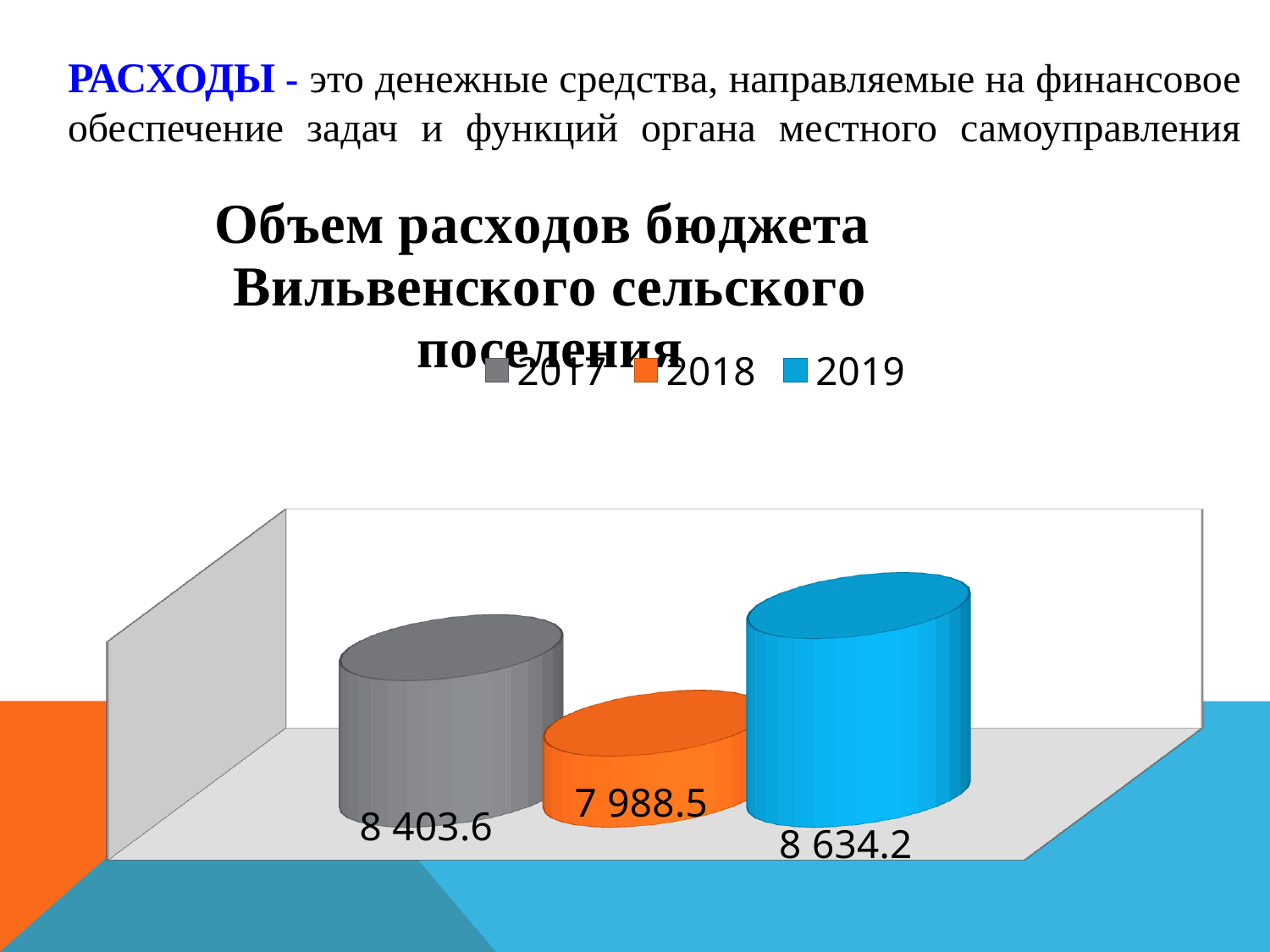
Which is larger, the value for 2017 or the value for 2018? 2017 How many series does the legend list? 3 What is the value shown for 2017? 8 403.6 What is the value shown for 2019? 8 634.2 Which year has the lowest value? 2018 What is the difference between the values for 2019 and 2017? 230.6 What is the value shown for 2018? 7 988.5 What colour represents 2018 in the legend? Orange What kind of chart is shown on the slide? Bar chart Which year has the highest value? 2019 What is the title of the chart? Объем расходов бюджета Вильвенского сельского поселения What is the difference between the values for 2017 and 2018? 415.1